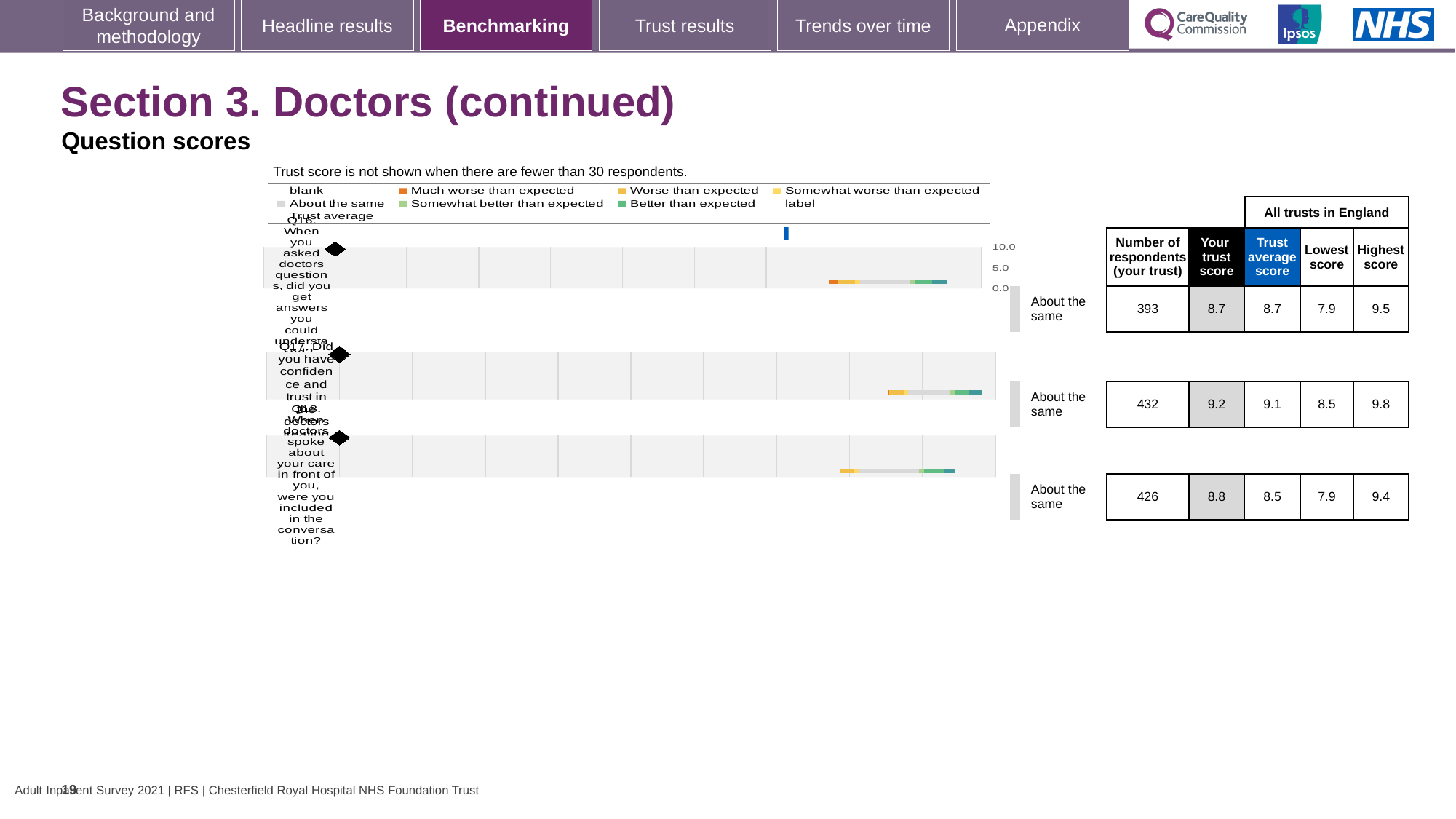
How many questions (Q16, Q17, Q18) are plotted in the chart? 3 What is the difference between the highest score and the lowest score for Q18? 1.5 Which question has the lowest number of respondents? Q16 What is your trust score for Q16? 8.7 What is the number of respondents (your trust) for Q17? 432 For Q18, which is larger: your trust score or the trust average score? Your trust score What is the highest tick value shown on the chart's score axis? 10.0 What is the trust average score for Q18? 8.5 What benchmark category is shown for Q17? About the same Which question has the highest 'Your trust score'? Q17 What kind of chart is used to show the question scores on this slide? bar chart What is the lowest score across all trusts in England for Q17? 8.5